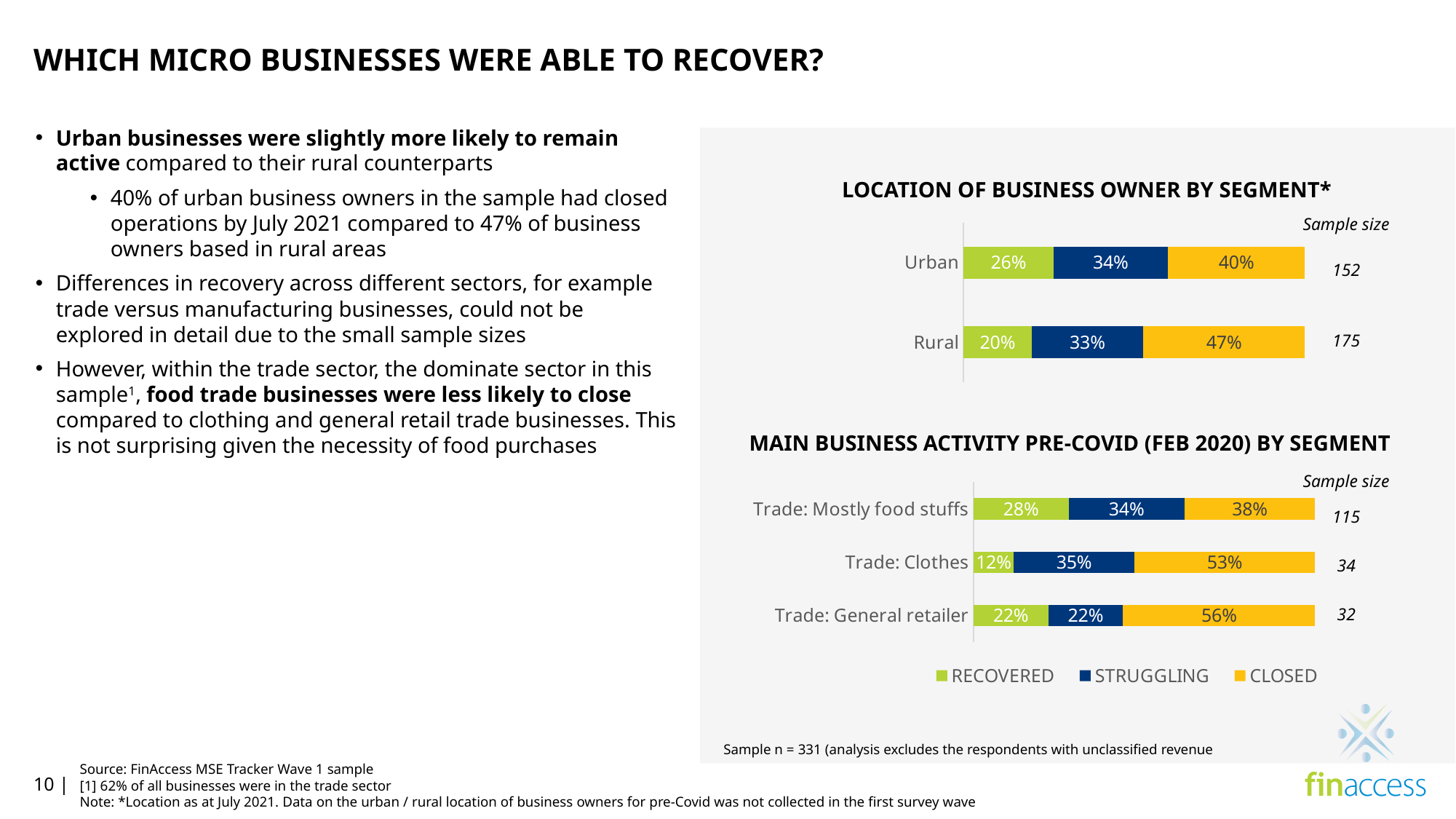
How many series does the legend list for the charts on the slide? 3 In the 'Location of business owner by segment' chart, what is the sample size for Rural? 175 In the 'Main business activity pre-Covid (Feb 2020) by segment' chart, what percentage of 'Trade: Clothes' businesses were struggling? 35% In the 'Location of business owner by segment' chart, which segment has the larger recovered share, Urban or Rural? Urban In the 'Main business activity pre-Covid (Feb 2020) by segment' chart, which category has the lowest recovered share? Trade: Clothes In the 'Main business activity pre-Covid (Feb 2020) by segment' chart, what is the sample size for 'Trade: Mostly food stuffs'? 115 What type of chart is the 'Location of business owner by segment' chart? Stacked bar chart In the 'Location of business owner by segment' chart, what percentage of urban businesses were closed? 40% In the 'Main business activity pre-Covid (Feb 2020) by segment' chart, how many categories are shown? 3 In the 'Location of business owner by segment' chart, what percentage of rural businesses had recovered? 20% In the 'Main business activity pre-Covid (Feb 2020) by segment' chart, which category has the highest closed share? Trade: General retailer In the 'Location of business owner by segment' chart, what is the difference between the closed share for Rural and the closed share for Urban? 7 percentage points